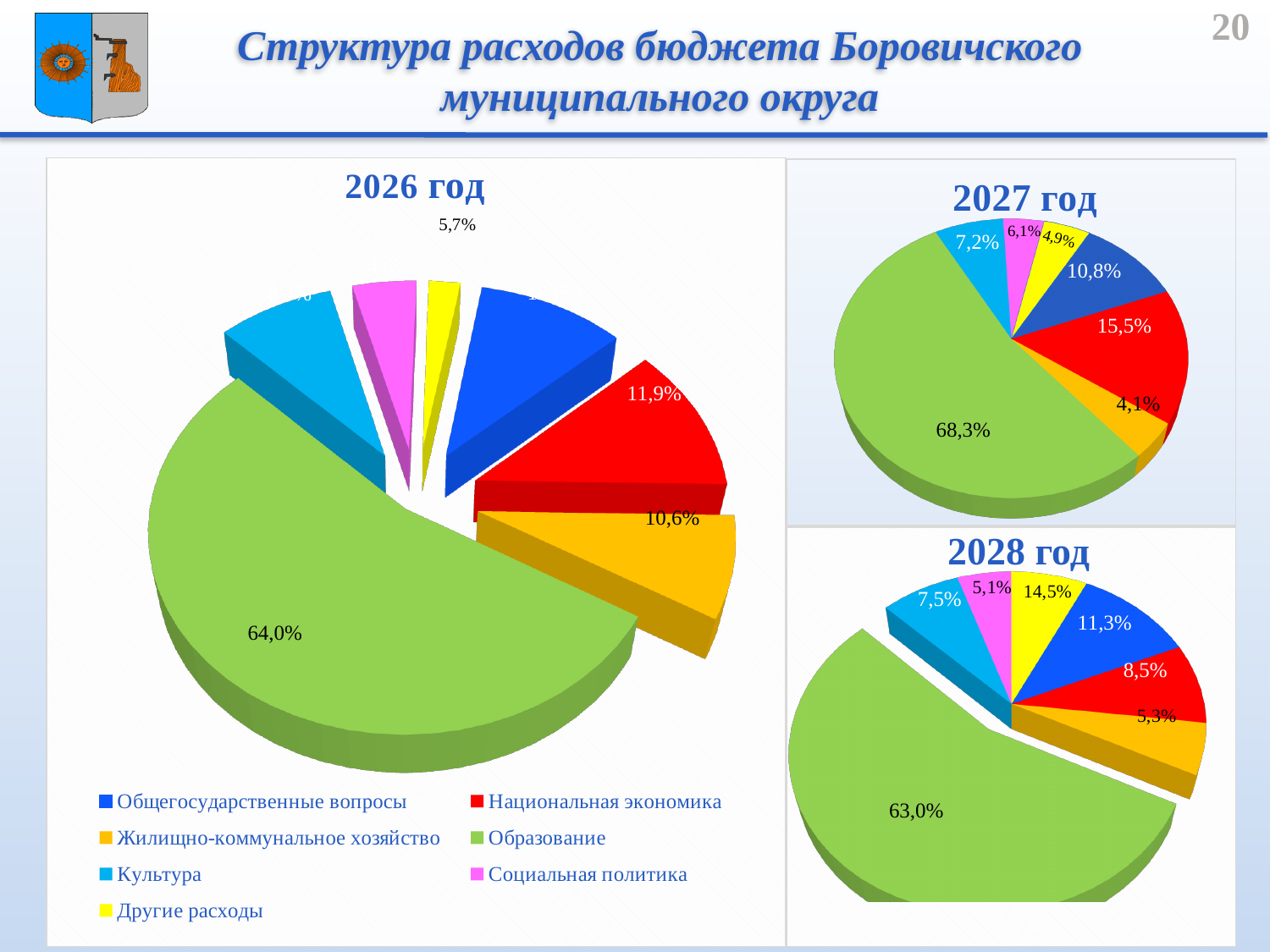
In the 2027 год chart, what share does Образование have? 68,3% Which is larger: the share of Образование in 2027 год or in 2028 год? 2027 год In the 2028 год chart, which category has the largest share? Образование How many categories does the legend list? 7 In the 2027 год chart, which category has the smallest share? Жилищно-коммунальное хозяйство In the 2026 год chart, what share does Жилищно-коммунальное хозяйство have? 10,6% In the 2026 год chart, what share does Национальная экономика have? 11,9% In the 2028 год chart, what is the difference between the shares of Общегосударственные вопросы and Национальная экономика? 2,8% In the 2026 год chart, what share does Образование have? 64,0% In the 2027 год chart, what share does Национальная экономика have? 15,5% In the 2028 год chart, what share does Другие расходы have? 14,5% What kind of charts are shown on the slide? Pie charts